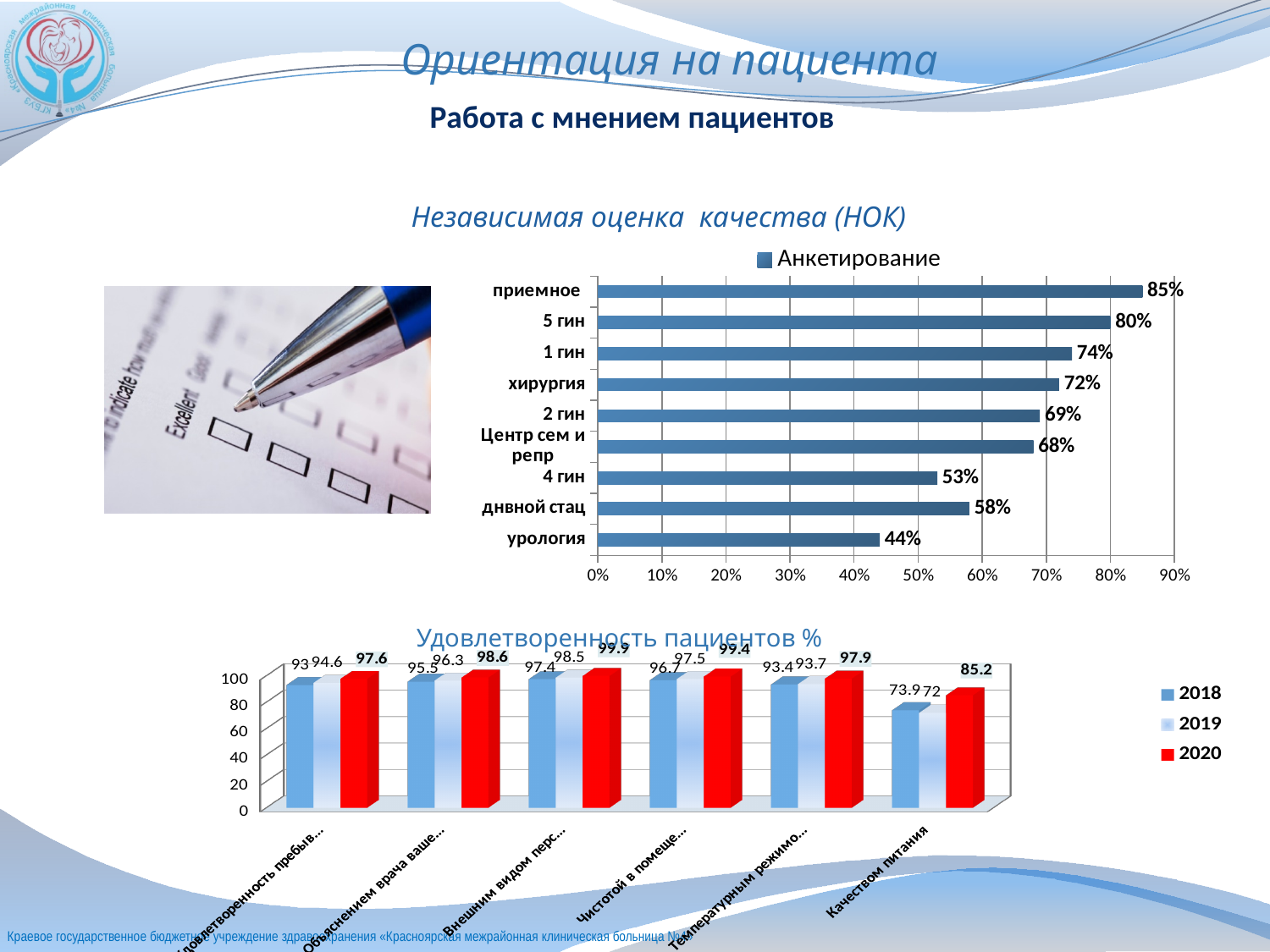
In the Удовлетворенность пациентов % chart, what is the 2020 value for Качеством питания? 85.2 In the Анкетирование chart, what is the value for 4 гин? 53% In the Анкетирование chart, what is the difference between the values for 5 гин and хирургия? 8% In the Анкетирование chart, which category has the highest value? приемное How many categories are shown in the Анкетирование chart? 9 In the Анкетирование chart, which is larger, the value for днвной стац or the value for 4 гин? днвной стац In the Анкетирование chart, which category has the lowest value? урология What kind of chart is the Анкетирование chart? bar chart How many series does the legend of the Удовлетворенность пациентов % chart list? 3 In the Анкетирование chart, what is the value for урология? 44% In the Анкетирование chart, what is the value for приемное? 85% In the Удовлетворенность пациентов % chart, what is the difference between the 2020 and 2019 values for Качеством питания? 13.2